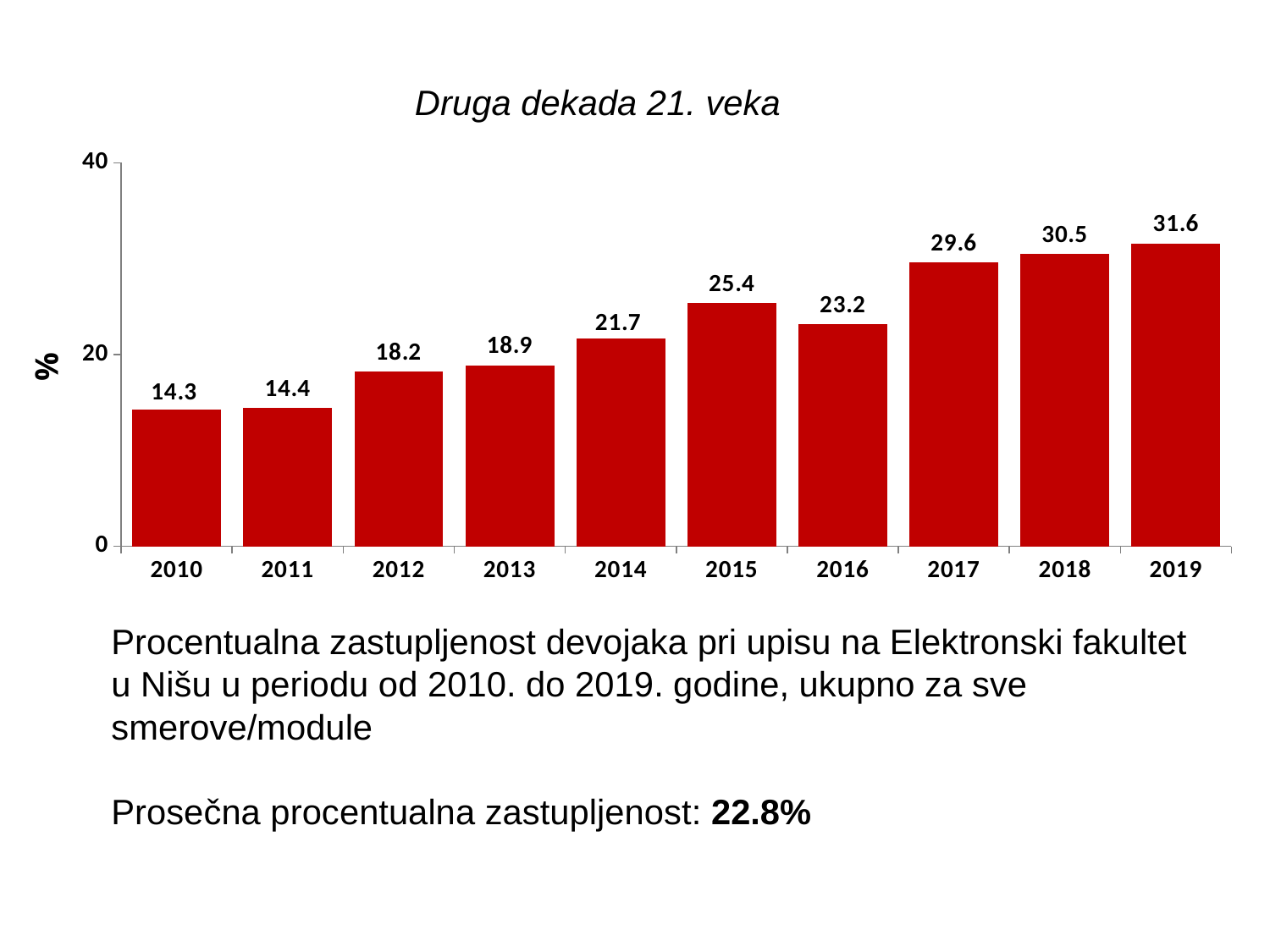
What is the value for 2015? 25.4 What is the difference between the values for 2019 and 2010? 17.3 How many years are shown on the x axis? 10 What kind of chart is shown on the slide? bar chart Is the value for 2014 greater or less than 20? greater Which year has the lowest value? 2010 What is the difference between the values for 2016 and 2015? 2.2 Which is larger, the value for 2015 or the value for 2016? 2015 Which year has the highest value? 2019 What is the value for 2017? 29.6 What is the title of the chart? Druga dekada 21. veka What is the value for 2010? 14.3